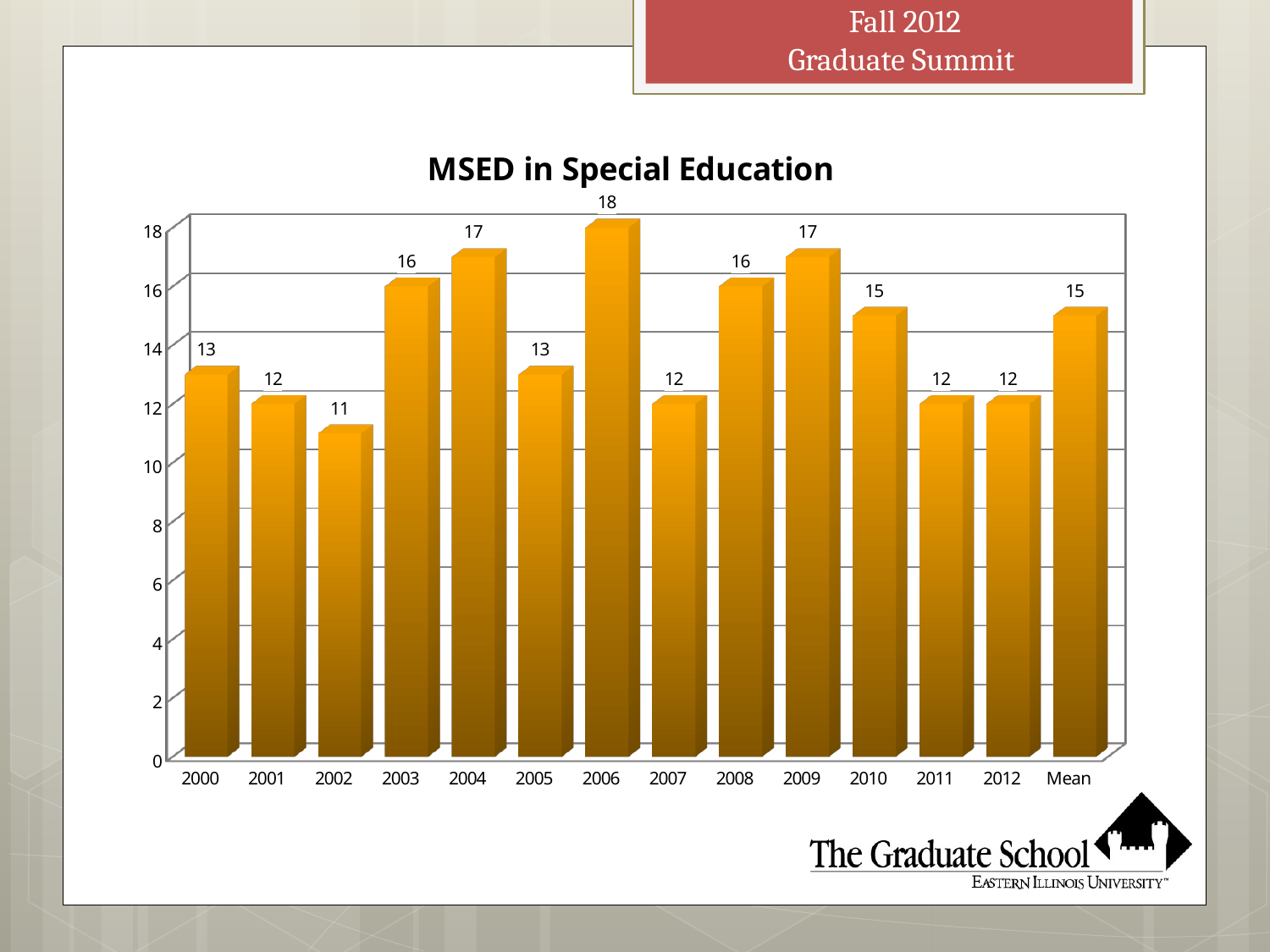
What is the difference between the values for 2006 and 2002? 7 Which year has the lowest value? 2002 What kind of chart is this? bar chart What is the value for 2002? 11 What is the value for 2006? 18 What is the title of the chart? MSED in Special Education Do the values rise or fall from 2000 to 2002? fall Which year has the highest value? 2006 Is the value for 2009 greater or less than 10? greater What is the Mean value shown in the chart? 15 How many categories are shown on the x axis? 14 Which is larger, the value for 2003 or the value for 2005? 2003